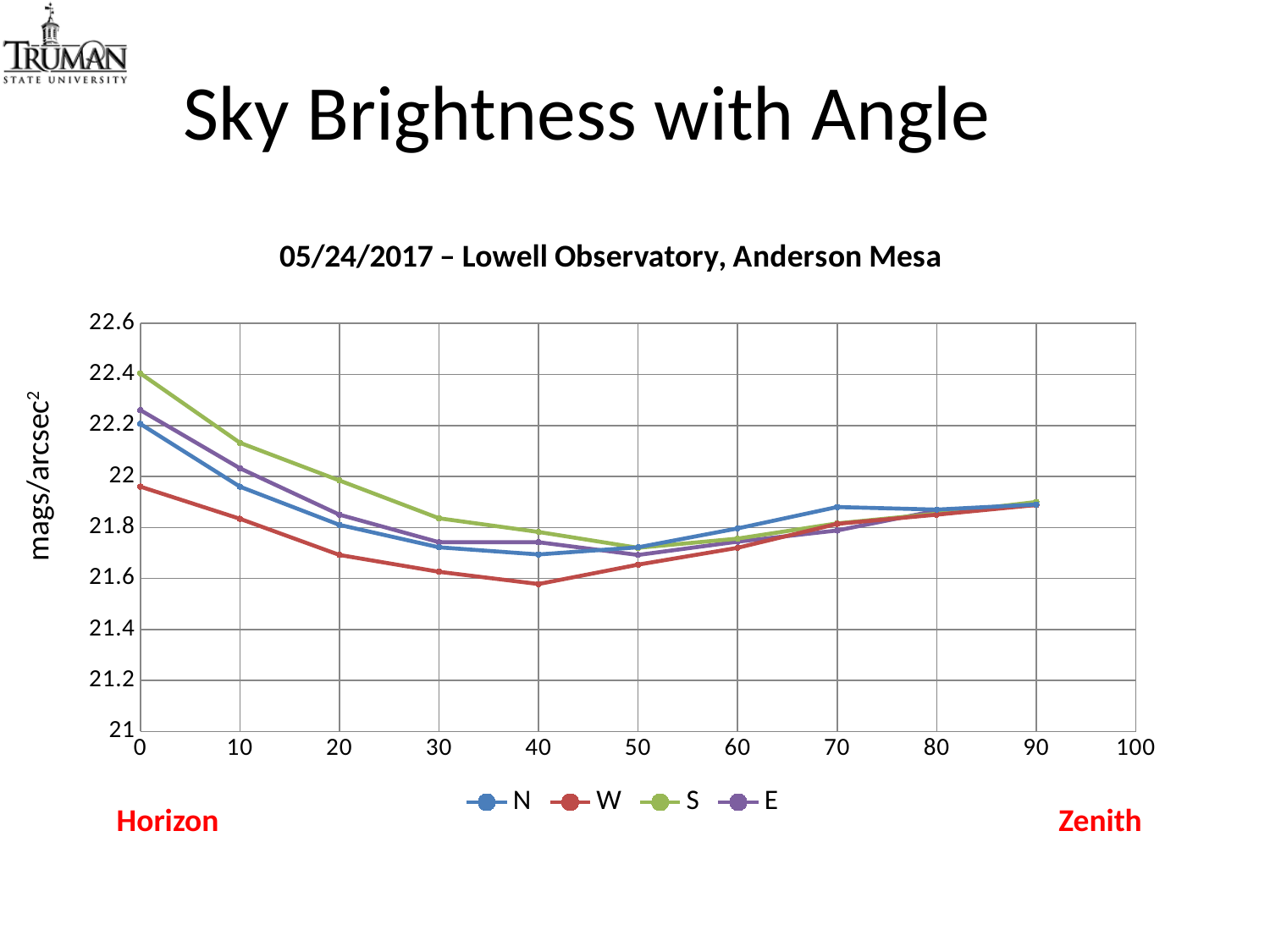
What is the label on the y axis? mags/arcsec² Is the value for S at angle 0 greater or less than 22.2? greater At angle 40, which series has the larger value, S or W? S Does the S series rise or fall from angle 0 to angle 40? fall Is the value for N at angle 70 greater or less than 21.8? greater Is the value for W at angle 0 greater or less than 22? less How many series does the legend list? 4 What kind of chart is shown on the slide? line chart Which series has the highest value at angle 0? S What is the title of the chart? 05/24/2017 – Lowell Observatory, Anderson Mesa Which series has the lowest value at angle 0? W